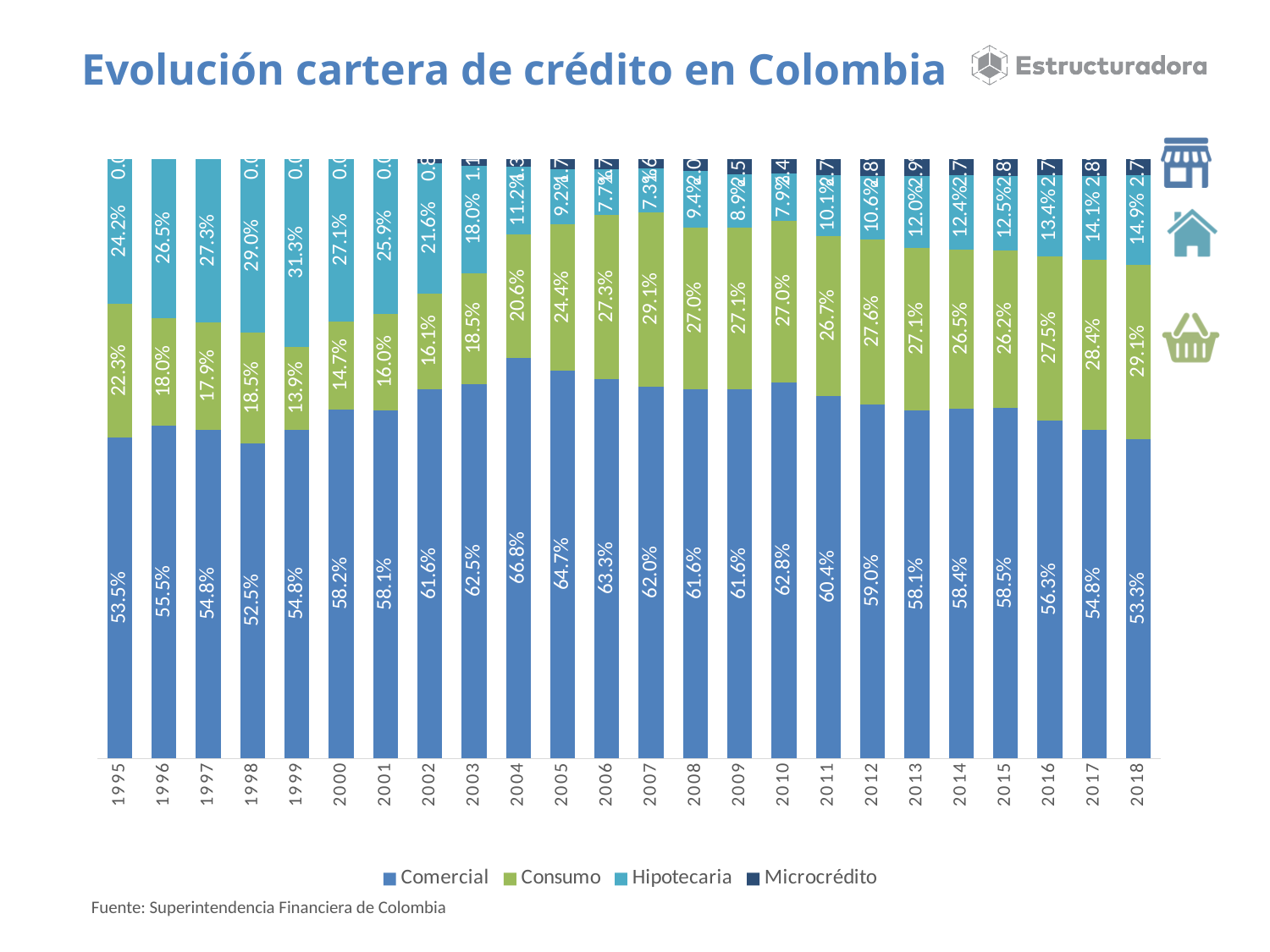
How many years are shown on the x axis? 24 What is the difference between the Comercial share in 2004 and in 1995? 13.3 percentage points What is the Comercial share in 2004? 66.8% In which year is the Comercial share highest? 2004 In which year is the Consumo share lowest? 1999 What is the Hipotecaria share in 1999? 31.3% What is the Consumo share in 2018? 29.1% How many series does the legend list? 4 What type of chart is shown on the slide? Stacked bar chart Which is larger, the Hipotecaria share in 1999 or in 2018? 1999 Does the Hipotecaria share rise or fall from 2007 to 2018? Rise In which year is the Hipotecaria share lowest? 2007